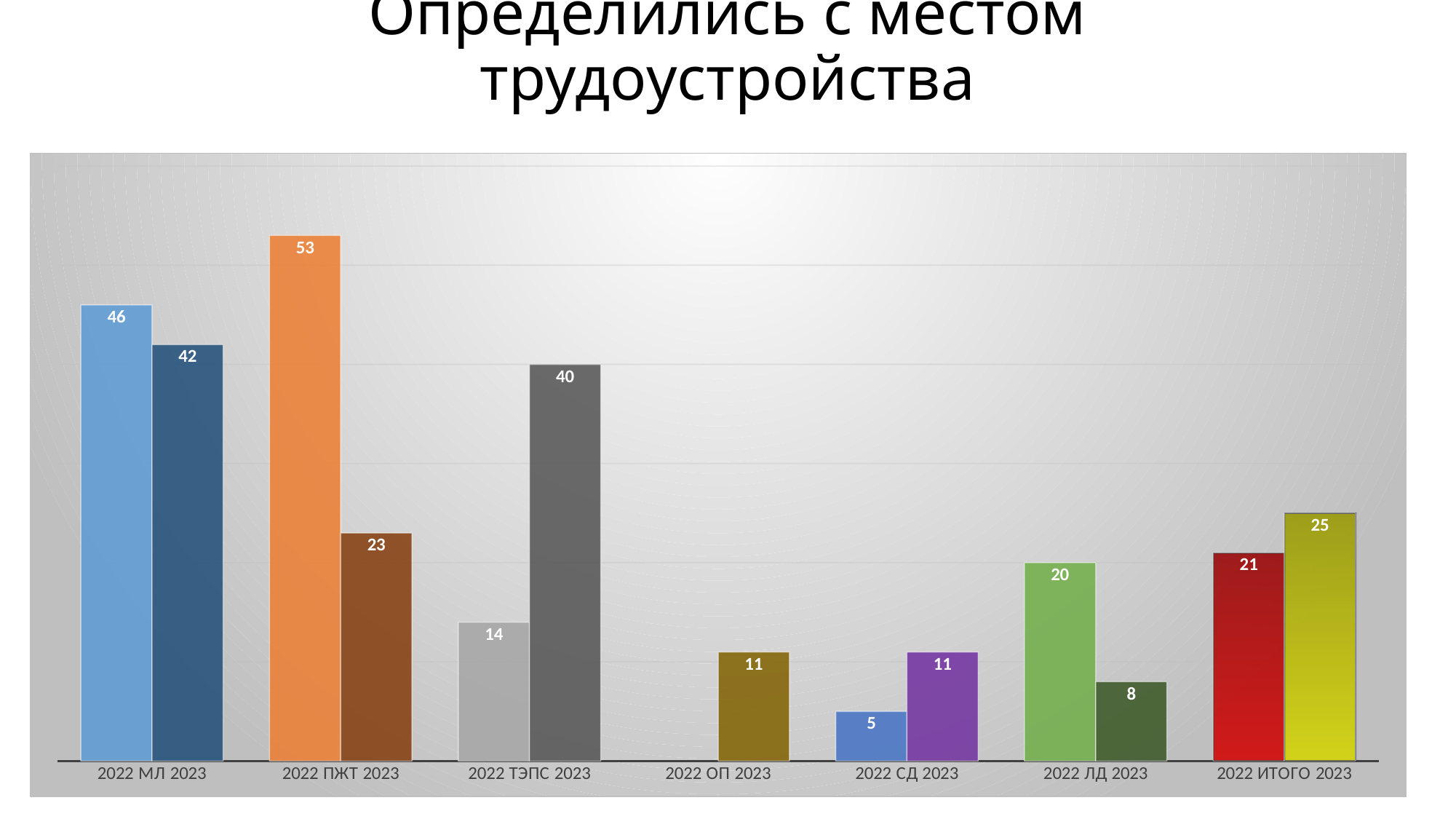
What is the value for ТЭПС in 2023? 40 Which bar has the lowest value on the chart? СД 2022 (5) What is the difference between the 2023 and 2022 values for ТЭПС? 26 What is the value for ПЖТ in 2023? 23 What is the value for ИТОГО in 2023? 25 How many groups (categories) are shown on the x axis? 7 What is the title of the slide? Определились с местом трудоустройства What kind of chart is shown on the slide? Bar chart Which bar has the highest value on the chart? ПЖТ 2022 (53) What is the value for МЛ in 2022? 46 Which is larger for ЛД: the 2022 value or the 2023 value? 2022 (20) What is the difference between the 2022 and 2023 values for ПЖТ? 30